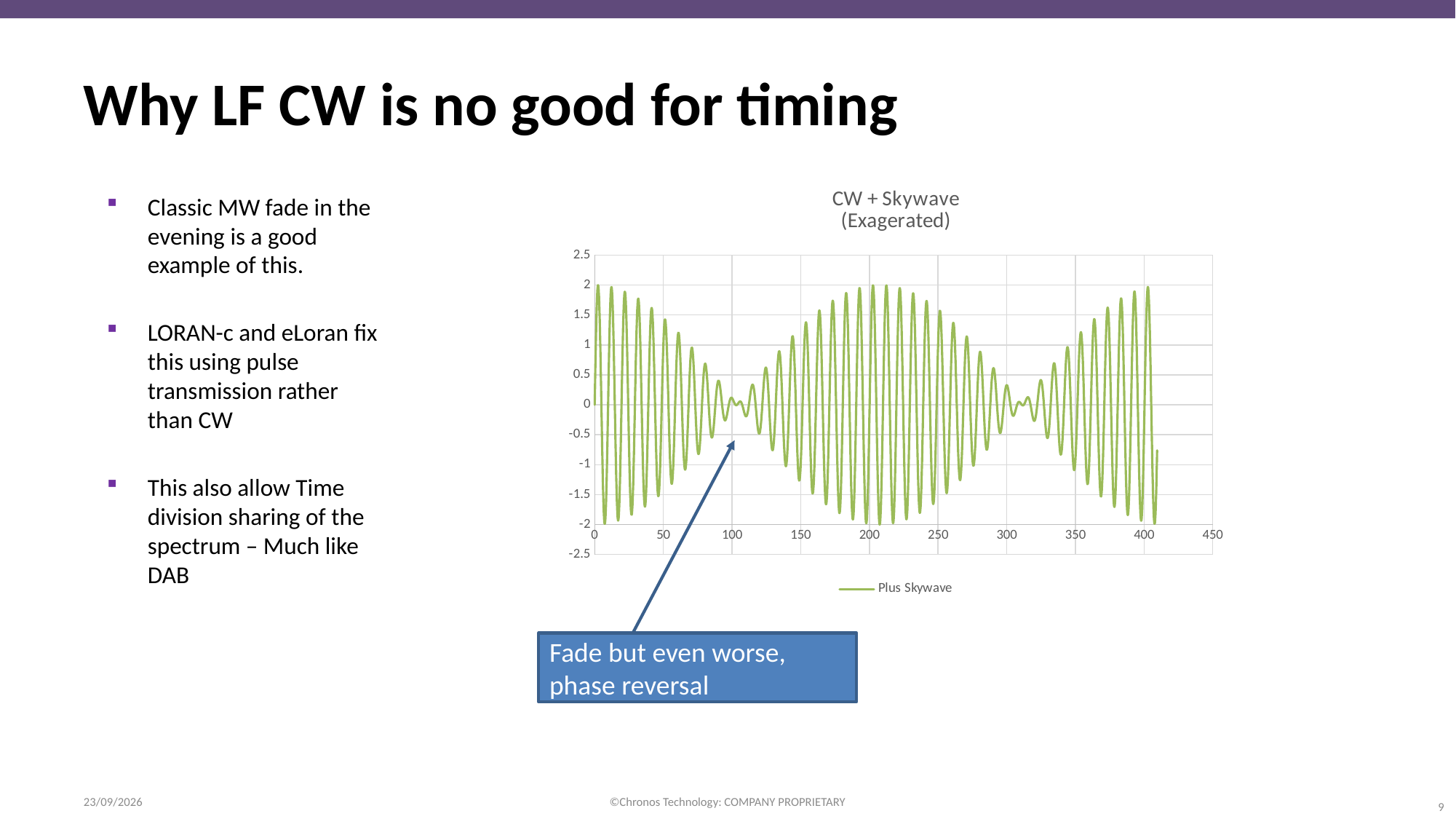
Is the peak amplitude of the Plus Skywave line larger near x = 200 or near x = 100? near x = 200 What kind of chart is shown on the slide? line chart Is the largest value of the Plus Skywave line near x = 310 greater or less than 0.5? less Is the peak value of the Plus Skywave line near x = 200 greater or less than 1.5? greater Is the peak amplitude of the Plus Skywave line larger near x = 310 or near x = 400? near x = 400 Is the largest value of the Plus Skywave line near x = 100 greater or less than 0.5? less What is the title of the chart? CW + Skywave (Exagerated) What is the highest value shown on the chart's vertical axis? 2.5 How many series does the chart's legend list? 1 What is the name of the series shown in the chart's legend? Plus Skywave